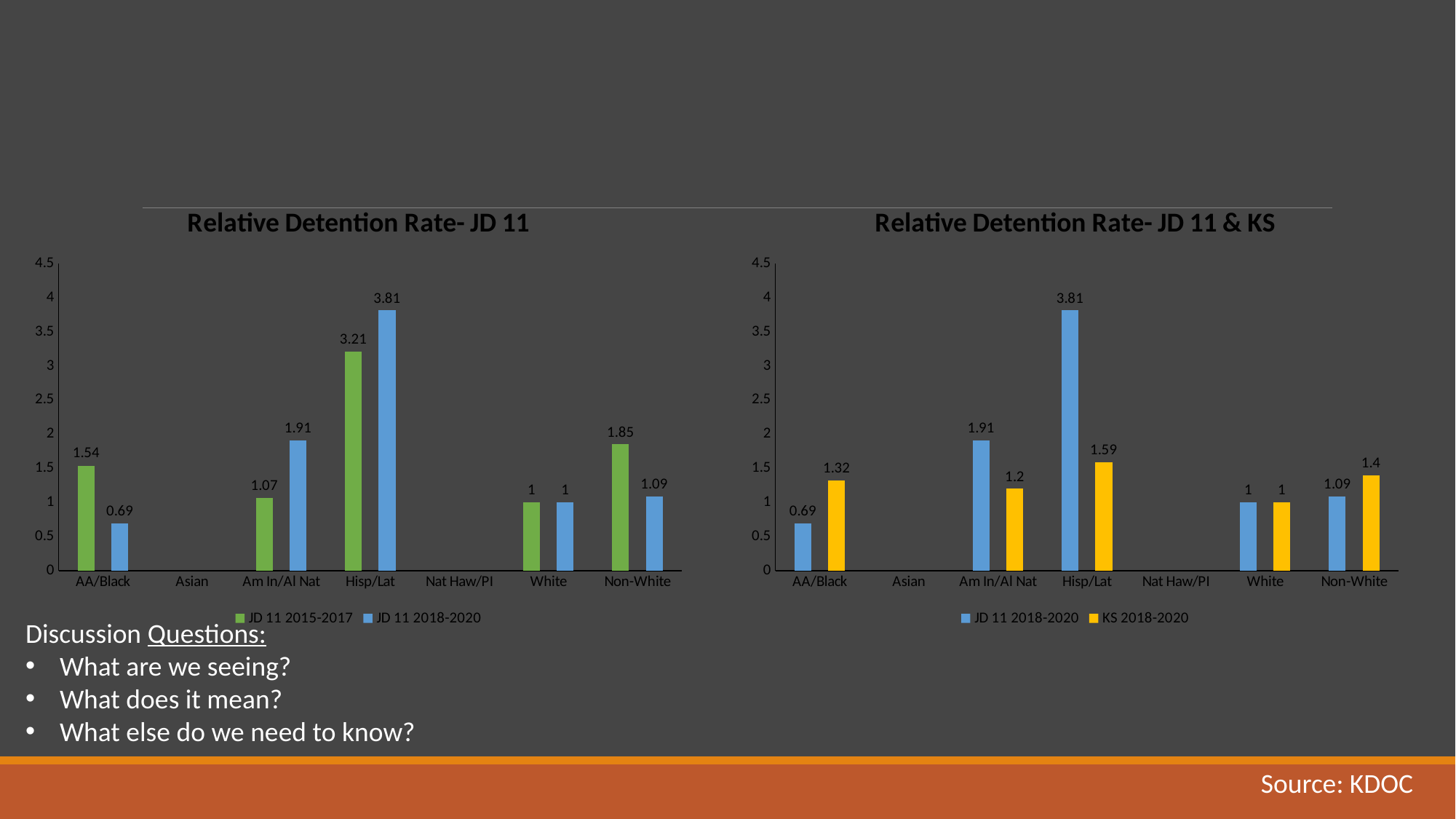
What type of chart is the 'Relative Detention Rate- JD 11 & KS' chart? Bar chart In the 'Relative Detention Rate- JD 11 & KS' chart, which is larger for AA/Black: the JD 11 2018-2020 value or the KS 2018-2020 value? KS 2018-2020 How many categories are shown on the x axis of the 'Relative Detention Rate- JD 11 & KS' chart? 7 In the 'Relative Detention Rate- JD 11' chart, which is larger for Am In/Al Nat: the JD 11 2015-2017 value or the JD 11 2018-2020 value? JD 11 2018-2020 In the 'Relative Detention Rate- JD 11' chart, how many series does the legend list? 2 In the 'Relative Detention Rate- JD 11' chart, what is the value for Hisp/Lat in the JD 11 2015-2017 series? 3.21 In the 'Relative Detention Rate- JD 11 & KS' chart, what is the difference between the JD 11 2018-2020 and KS 2018-2020 values for Hisp/Lat? 2.22 In the 'Relative Detention Rate- JD 11 & KS' chart, what is the value for Non-White in the KS 2018-2020 series? 1.4 In the 'Relative Detention Rate- JD 11' chart, which category has the highest value in the JD 11 2018-2020 series? Hisp/Lat In the 'Relative Detention Rate- JD 11 & KS' chart, what is the value for Hisp/Lat in the KS 2018-2020 series? 1.59 In the 'Relative Detention Rate- JD 11' chart, what is the difference between the JD 11 2015-2017 and JD 11 2018-2020 values for Non-White? 0.76 In the 'Relative Detention Rate- JD 11' chart, what is the value for AA/Black in the JD 11 2018-2020 series? 0.69